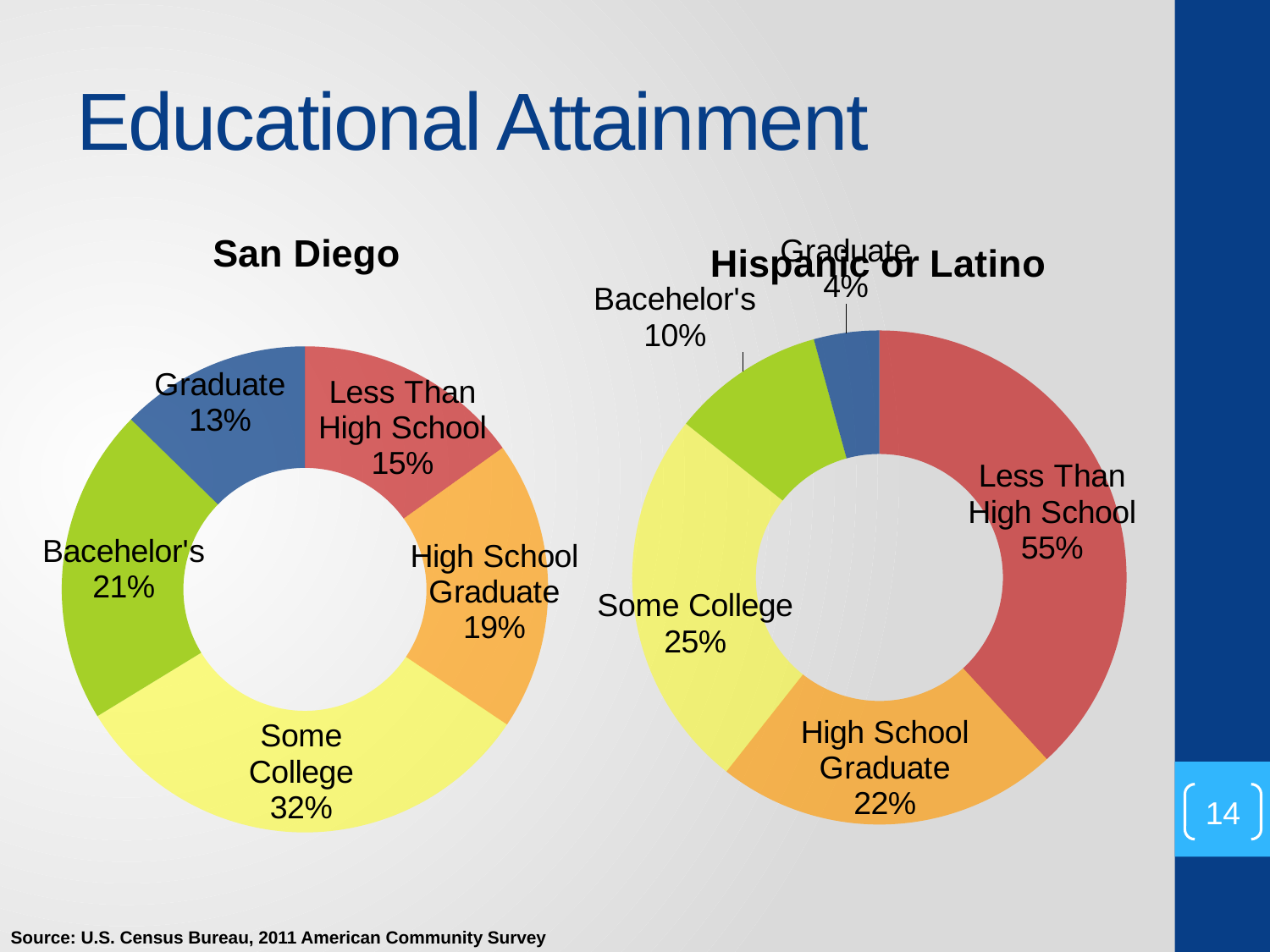
In the Hispanic or Latino chart, what percentage is shown for Bachelor's? 10% What is the difference between the Less Than High School share in the Hispanic or Latino chart and in the San Diego chart? 40 percentage points In the Hispanic or Latino chart, what percentage is shown for Less Than High School? 55% What kind of chart is the Hispanic or Latino chart? Doughnut (pie) chart How many categories does the San Diego chart show? 5 Which is larger: the High School Graduate share in the San Diego chart or in the Hispanic or Latino chart? Hispanic or Latino In the San Diego chart, which category has the largest share? Some College What is the title of the slide? Educational Attainment In the San Diego chart, what percentage is shown for Some College? 32% In the San Diego chart, what is the combined share of Bachelor's and Graduate? 34% In the San Diego chart, what percentage is shown for Graduate? 13% In the Hispanic or Latino chart, which category has the smallest share? Graduate